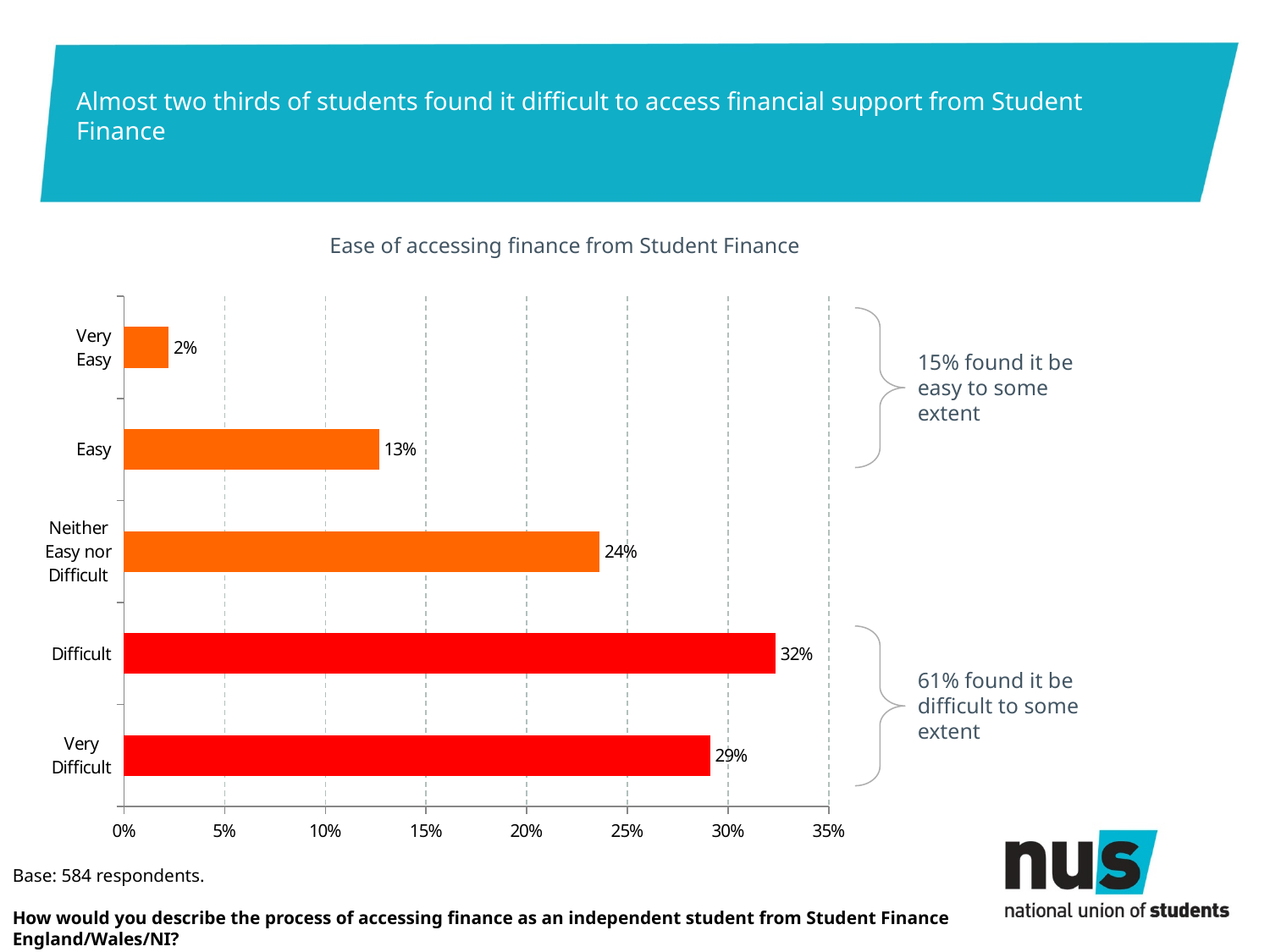
What kind of chart is shown on the slide? Bar chart What is the difference between the 'Difficult' and 'Very Difficult' values? 3% What percentage of respondents chose 'Neither Easy nor Difficult'? 24% Which is larger, the value for 'Easy' or the value for 'Neither Easy nor Difficult'? Neither Easy nor Difficult Which category has the lowest value? Very Easy How many categories are shown on the chart? 5 What percentage of respondents found accessing finance from Student Finance 'Very Easy'? 2% What is the value for the 'Difficult' category? 32% What is the combined value of the 'Very Easy' and 'Easy' categories? 15% Is the value for 'Very Difficult' greater or less than 25%? greater What is the title of the chart? Ease of accessing finance from Student Finance Which category has the highest value? Difficult